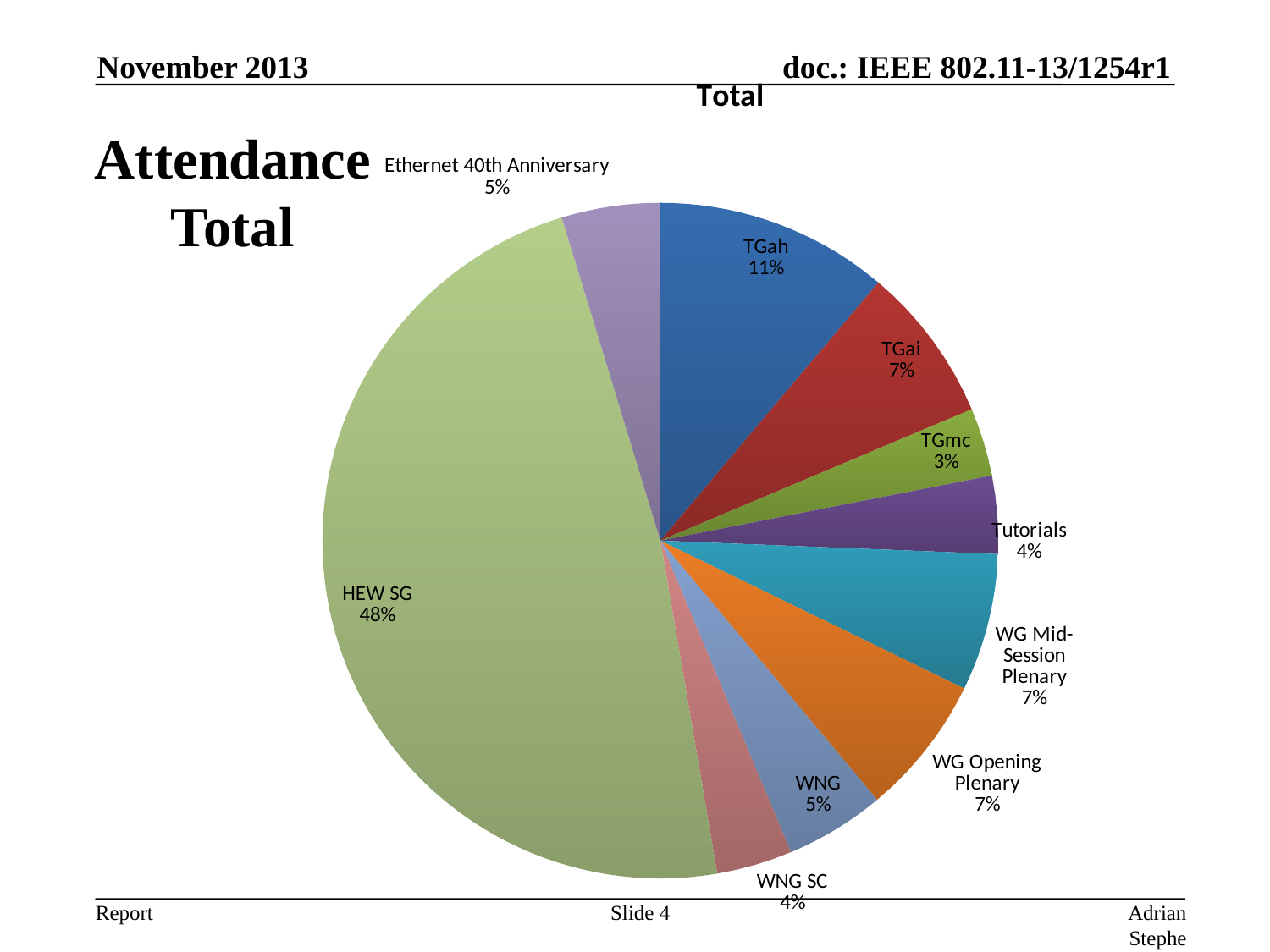
What is the difference in percentage points between HEW SG and TGah? 37 What share of the pie does HEW SG account for? 48% What percentage is shown for WG Mid-Session Plenary? 7% Which slice of the pie is the smallest? TGmc Which is larger, the share for TGai or the share for WNG? TGai How many slices does the pie chart have? 10 What is the title of the chart? Total What percentage is shown for TGah? 11% What kind of chart is shown on the slide? pie chart What percentage is shown for Ethernet 40th Anniversary? 5% Which slice of the pie is the largest? HEW SG What percentage is shown for TGmc? 3%